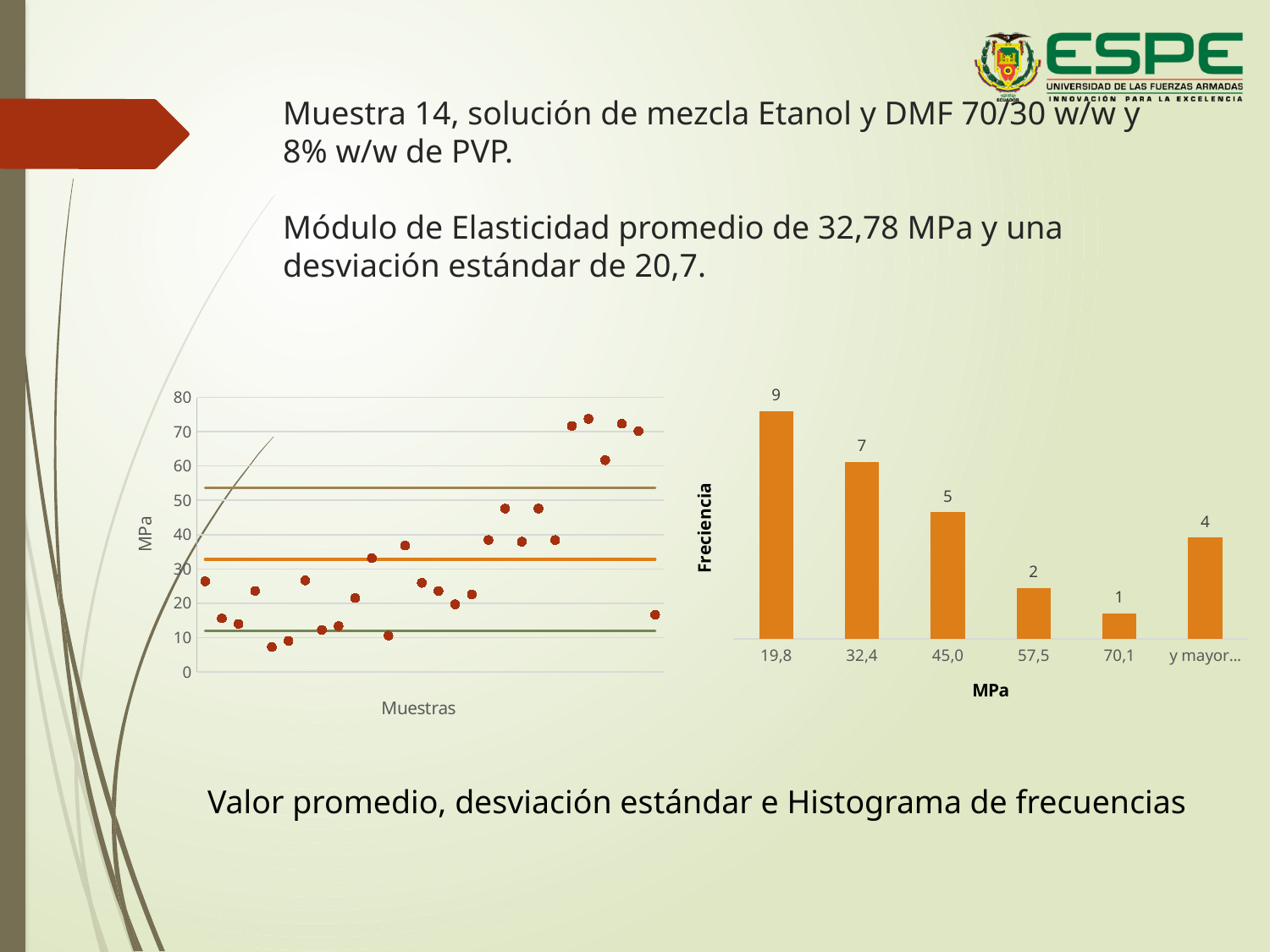
In the histogram on the right, which bin has the lowest frequency? 70,1 In the histogram on the right, what is the difference between the frequencies of the 32,4 bin and the 57,5 bin? 5 In the histogram on the right, what is the frequency for the 45,0 bin? 5 What type of chart is the chart on the left? Scatter plot In the histogram on the right, what is the frequency for the 19,8 bin? 9 In the histogram on the right, what is the frequency for the 70,1 bin? 1 What is the sum of all frequencies shown in the histogram on the right? 28 In the chart on the left, is the highest plotted point greater or less than 70 MPa? greater In the histogram on the right, which bin has a higher frequency, 57,5 or y mayor...? y mayor... How many bins are shown in the histogram on the right? 6 In the histogram on the right, which bin has the highest frequency? 19,8 What type of chart is the chart on the right? Bar chart